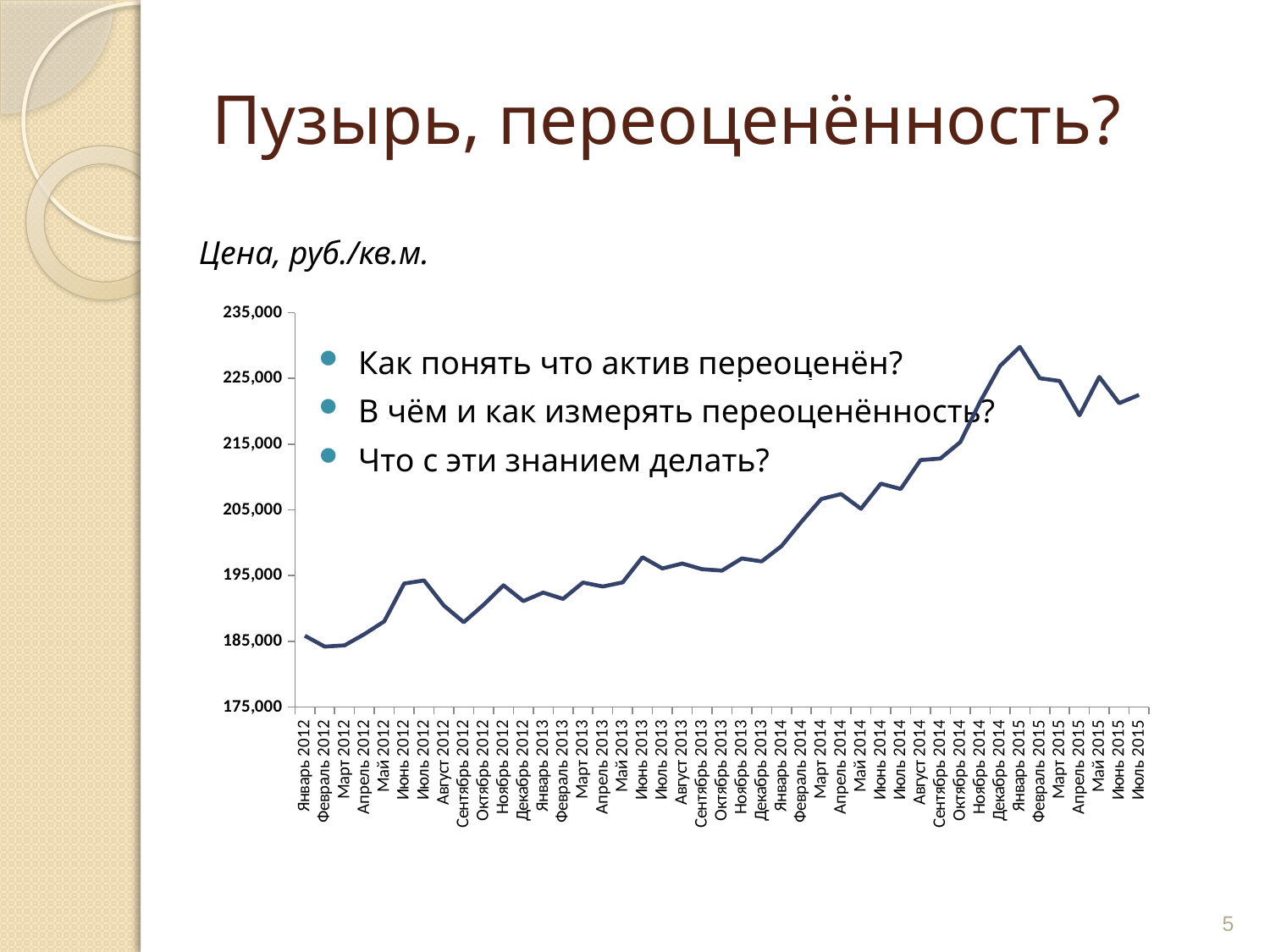
What unit label is shown above the chart for the plotted values? Цена, руб./кв.м. Overall, do the values rise or fall from Январь 2012 to Июль 2015? rise Is the value for Январь 2015 greater or less than 225,000? greater Is the value for Июнь 2013 greater or less than 195,000? greater Is the value for Июль 2015 greater or less than 215,000? greater Which is larger, the value for Январь 2012 or the value for Январь 2015? Январь 2015 What kind of chart is shown on the slide? line chart In which month does the line reach its highest value? Январь 2015 Which is larger, the value for Июль 2012 or the value for Июль 2015? Июль 2015 How many monthly data points are plotted on the chart, from Январь 2012 to Июль 2015? 43